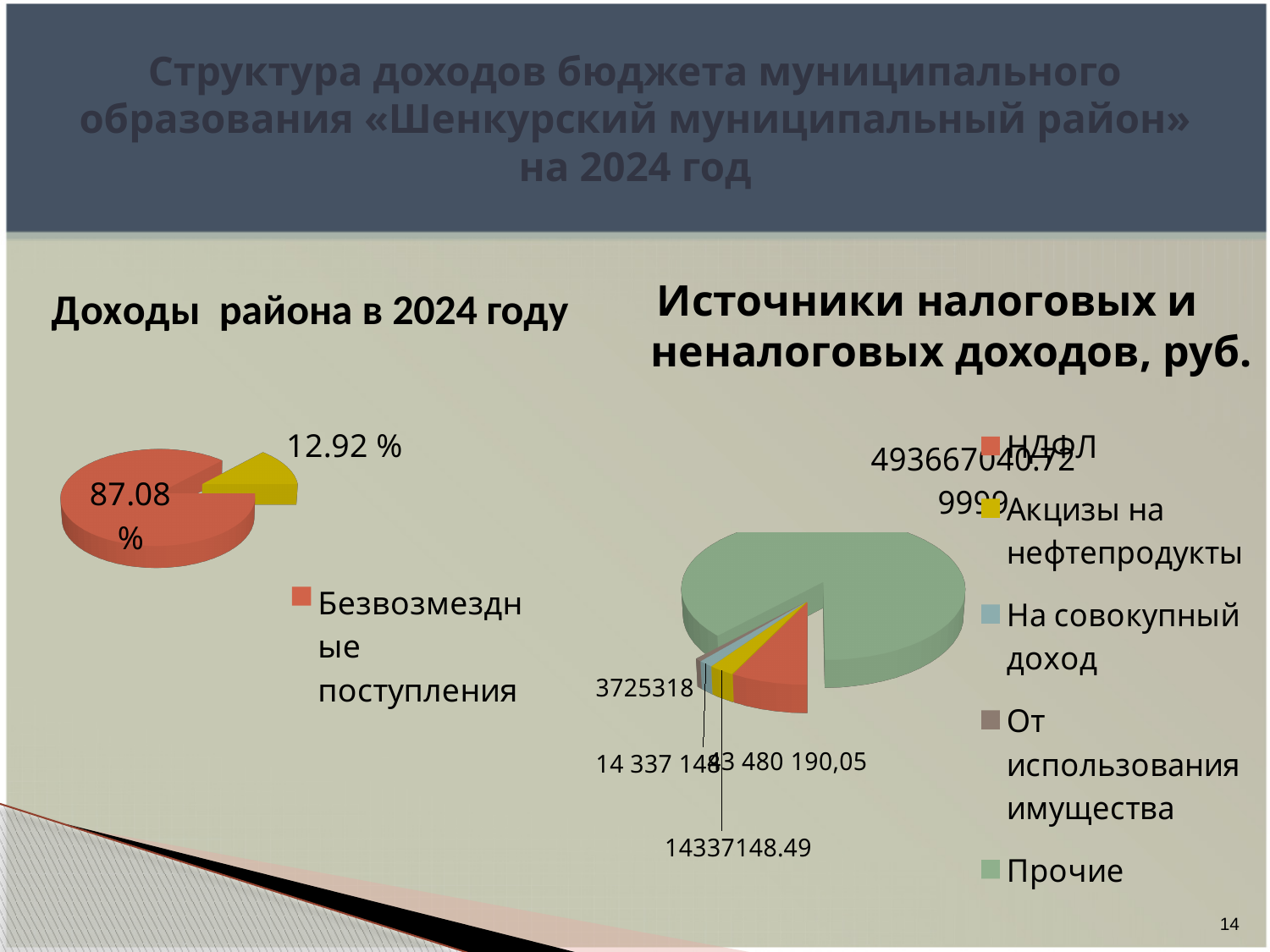
In the left chart "Доходы района в 2024 году", is the value for Безвозмездные поступления greater or less than 50%? greater How many entries does the legend of the right chart "Источники налоговых и неналоговых доходов, руб." list? 5 In the left chart "Доходы района в 2024 году", what value is shown on the smaller (yellow) slice? 12.92 % What is the title of the right chart on the slide? Источники налоговых и неналоговых доходов, руб. In the left chart "Доходы района в 2024 году", what is the value shown for Безвозмездные поступления? 87.08 % In the right chart "Источники налоговых и неналоговых доходов, руб.", which slice is larger: НДФЛ or Акцизы на нефтепродукты? НДФЛ In the left chart "Доходы района в 2024 году", which category has the largest slice? Безвозмездные поступления What kind of chart is the left chart titled "Доходы района в 2024 году"? Pie chart How many slices does the left chart "Доходы района в 2024 году" have? 2 In the right chart "Источники налоговых и неналоговых доходов, руб.", which category has the largest slice? Прочие In the right chart "Источники налоговых и неналоговых доходов, руб.", what colour represents Прочие? Green What kind of chart is the right chart "Источники налоговых и неналоговых доходов, руб."? Pie chart